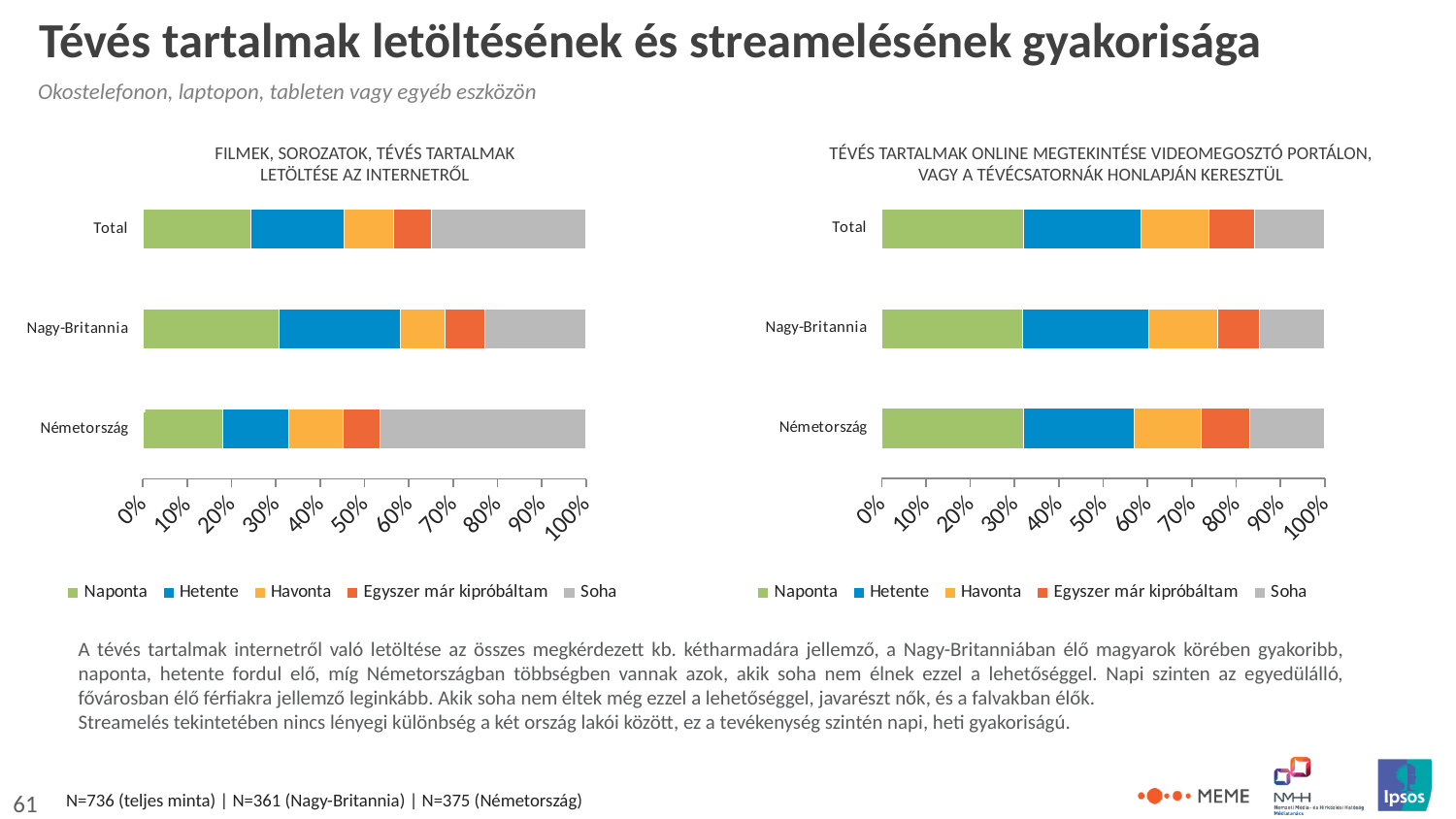
On the left chart, 'Filmek, sorozatok, tévés tartalmak letöltése az internetről', is the 'Soha' share larger for Nagy-Britannia or for Németország? Németország On the left chart, 'Filmek, sorozatok, tévés tartalmak letöltése az internetről', is the 'Naponta' value for Németország greater or less than 30%? less On the left chart, 'Filmek, sorozatok, tévés tartalmak letöltése az internetről', is the 'Naponta' share larger for Nagy-Britannia or for Németország? Nagy-Britannia How many categories are shown on the left chart, 'Filmek, sorozatok, tévés tartalmak letöltése az internetről'? 3 How many series does the legend of the right chart, 'Tévés tartalmak online megtekintése videomegosztó portálon, vagy a tévécsatornák honlapján keresztül', list? 5 On the left chart, 'Filmek, sorozatok, tévés tartalmak letöltése az internetről', is the 'Naponta' value for Nagy-Britannia greater or less than 20%? greater What kind of chart is the left chart, 'Filmek, sorozatok, tévés tartalmak letöltése az internetről'? Stacked bar chart On the right chart, 'Tévés tartalmak online megtekintése videomegosztó portálon, vagy a tévécsatornák honlapján keresztül', is the 'Naponta' value for Total greater or less than 20%? greater On the left chart, 'Filmek, sorozatok, tévés tartalmak letöltése az internetről', which category has the largest 'Naponta' segment? Nagy-Britannia Which legend entry is shown in grey on the right chart, 'Tévés tartalmak online megtekintése videomegosztó portálon, vagy a tévécsatornák honlapján keresztül'? Soha On the left chart, 'Filmek, sorozatok, tévés tartalmak letöltése az internetről', which category has the largest 'Soha' segment? Németország